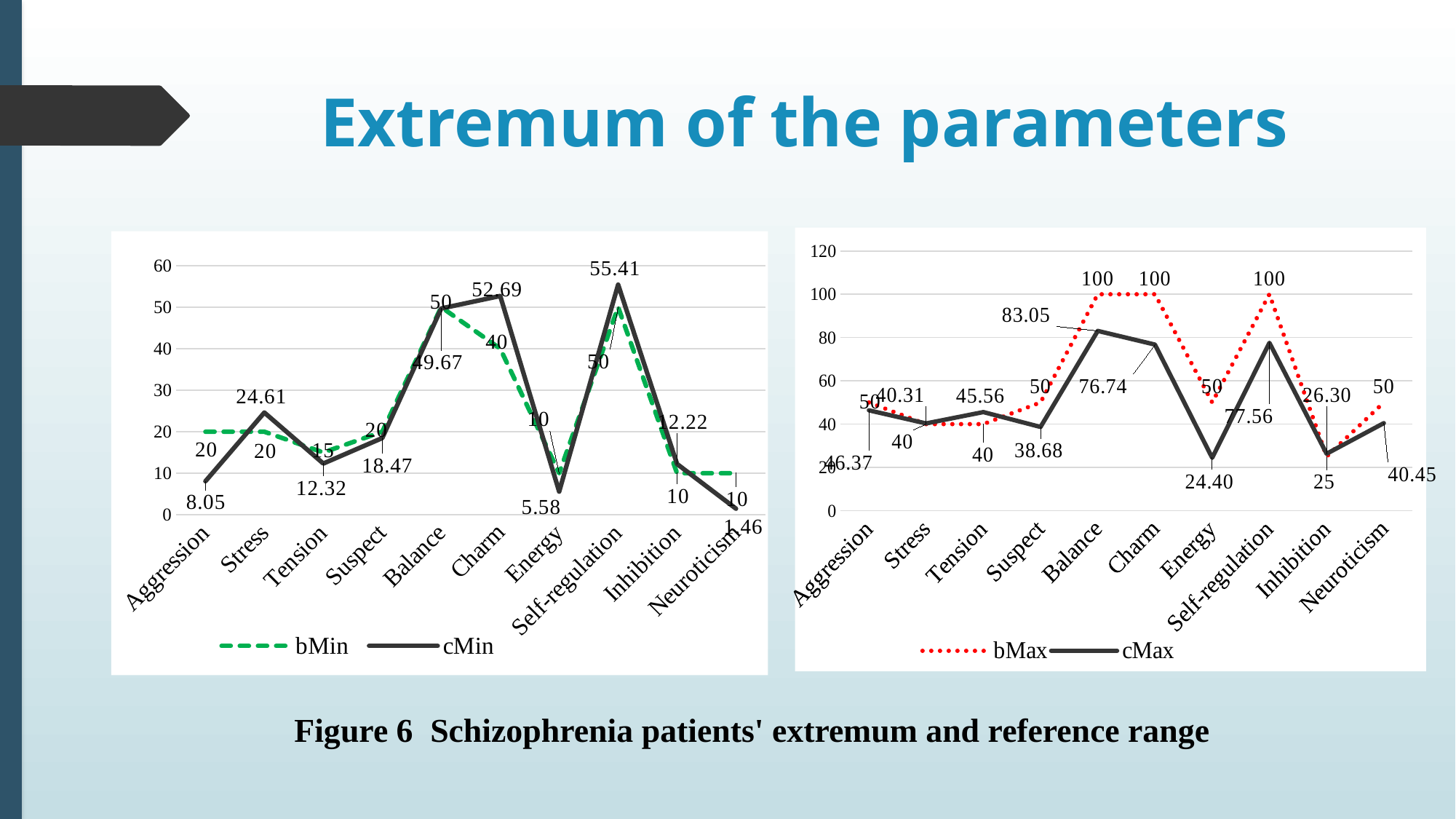
In the right chart, what are the two series named in the legend? bMax and cMax In the right chart, what is the cMax value for Balance? 83.05 In the left chart, what is the cMin value for Aggression? 8.05 In the left chart, which category has the lowest cMin value? Neuroticism In the right chart, which category has the highest cMax value? Balance What type of chart is the right chart? Line chart In the left chart, which is larger for Charm: the bMin value or the cMin value? cMin In the right chart, what is the bMax value for Inhibition? 25 How many categories are shown on the x axis of the right chart? 10 In the left chart, what is the cMin value for Self-regulation? 55.41 How many series does the legend of the left chart list? 2 In the right chart, what is the difference between the bMax and cMax values for Energy? 25.60